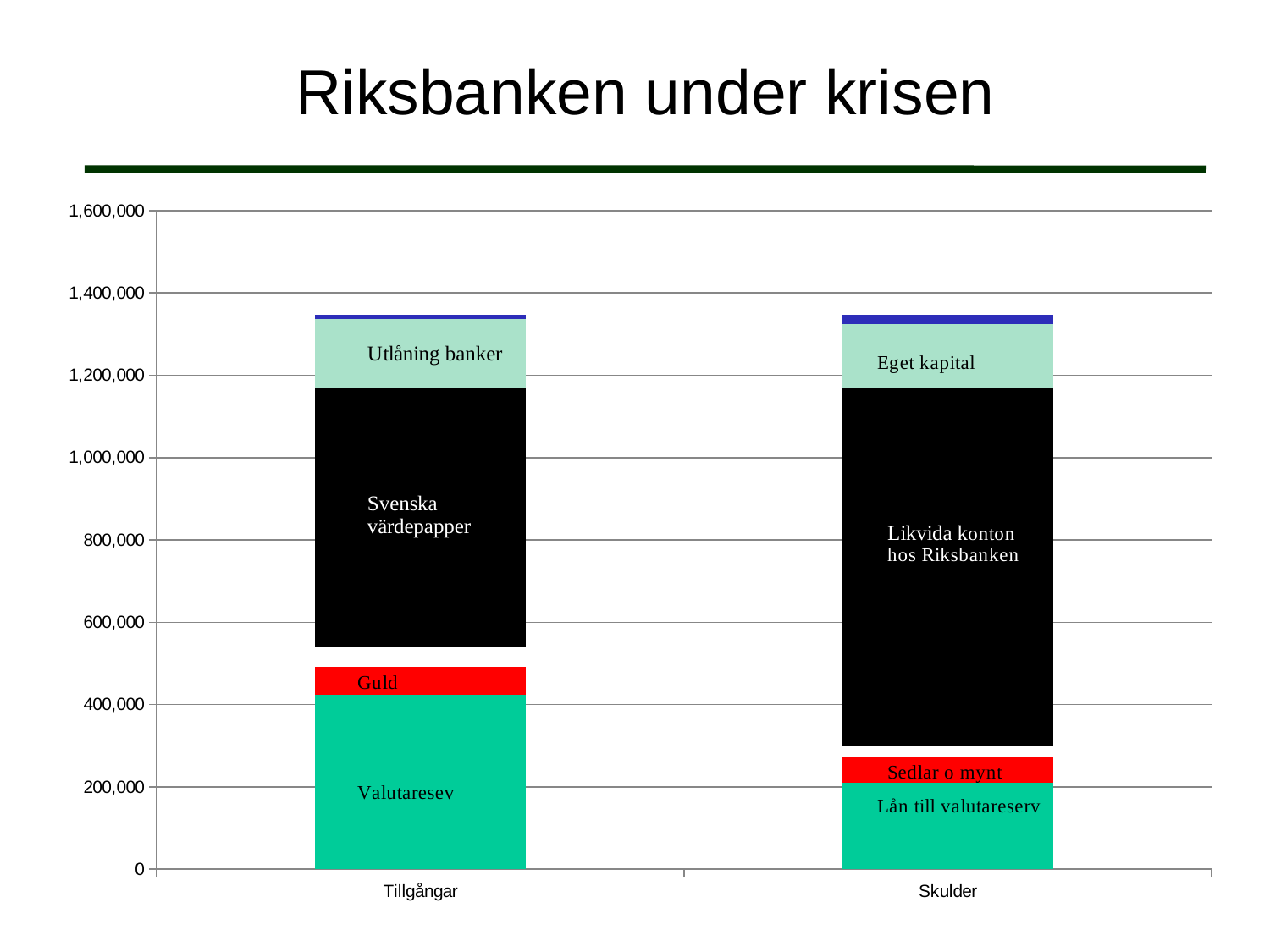
Is the top of the Valutaresev segment in the Tillgångar bar greater or less than 600,000? less What kind of chart is shown on the slide? Stacked bar chart Is the total height of the Skulder bar greater or less than 1,200,000? greater How many categories are shown on the x axis of the chart? 2 Which segment is the largest in the Tillgångar bar? Svenska värdepapper Which is larger in the Skulder bar: the Likvida konton hos Riksbanken segment or the Sedlar o mynt segment? Likvida konton hos Riksbanken What is the title of the slide containing the chart? Riksbanken under krisen Is the total height of the Skulder bar greater or less than 1,400,000? less Which segment is the largest in the Skulder bar? Likvida konton hos Riksbanken What are the two categories on the x axis of the chart? Tillgångar and Skulder